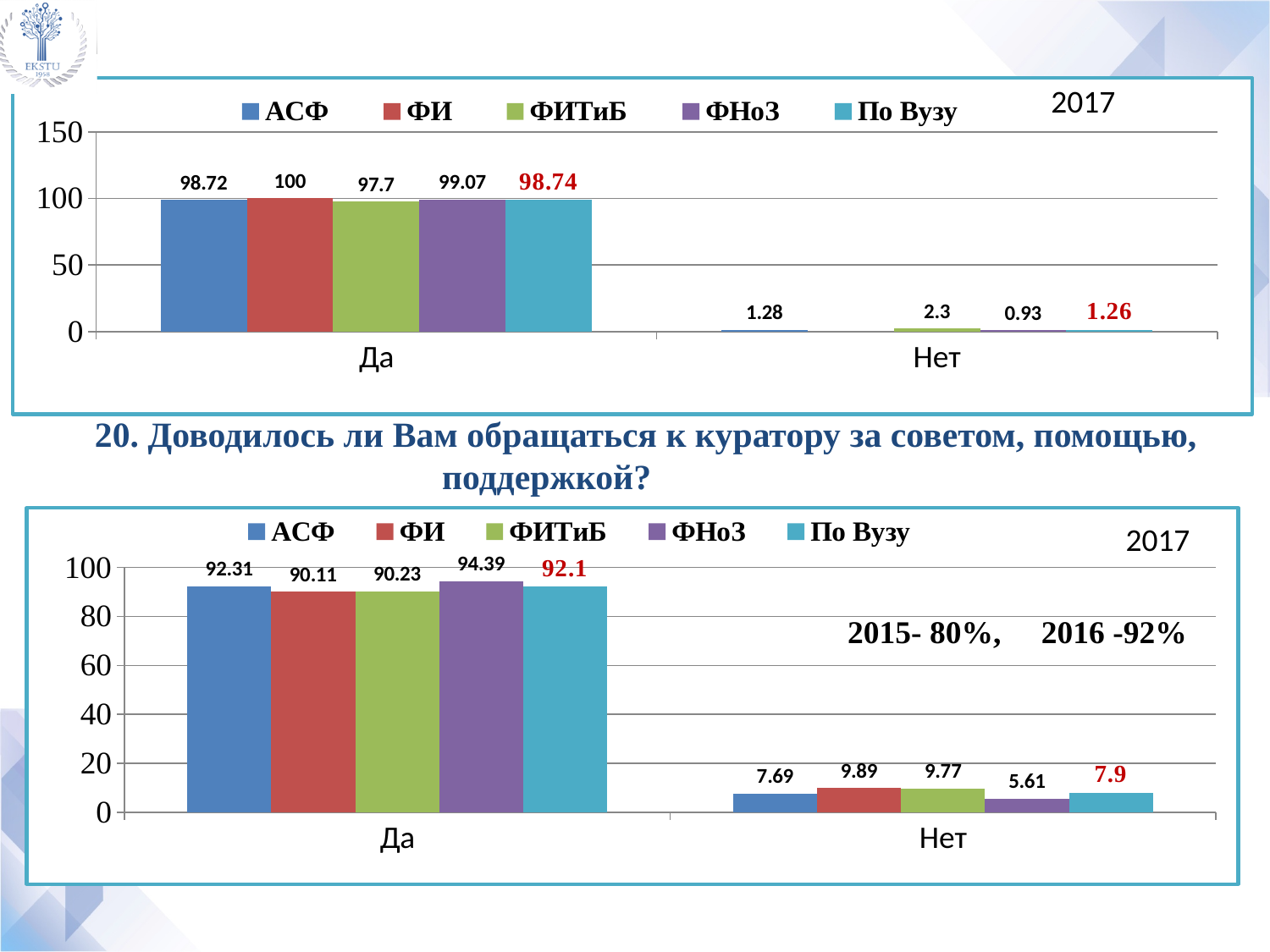
In the bottom chart, what is the value for ФНоЗ in the Да category? 94.39 In the bottom chart, what is the difference between the ФИ and ФНоЗ values in the Нет category? 4.28 In the top chart, what is the value for По Вузу in the Нет category? 1.26 What type of chart is the bottom chart? Bar chart In the bottom chart, what is the value for АСФ in the Нет category? 7.69 In the top chart, which series has the highest value in the Нет category? ФИТиБ How many series does the legend of the top chart list? 5 In the top chart, what is the value for ФИ in the Да category? 100 In the bottom chart, is the value for ФИ in the Да category larger or smaller than the value for ФНоЗ in the Да category? smaller In the bottom chart, which series has the lowest value in the Нет category? ФНоЗ In the bottom chart, which series has the highest value in the Да category? ФНоЗ In the top chart, what is the difference between the ФИ and ФИТиБ values in the Да category? 2.3